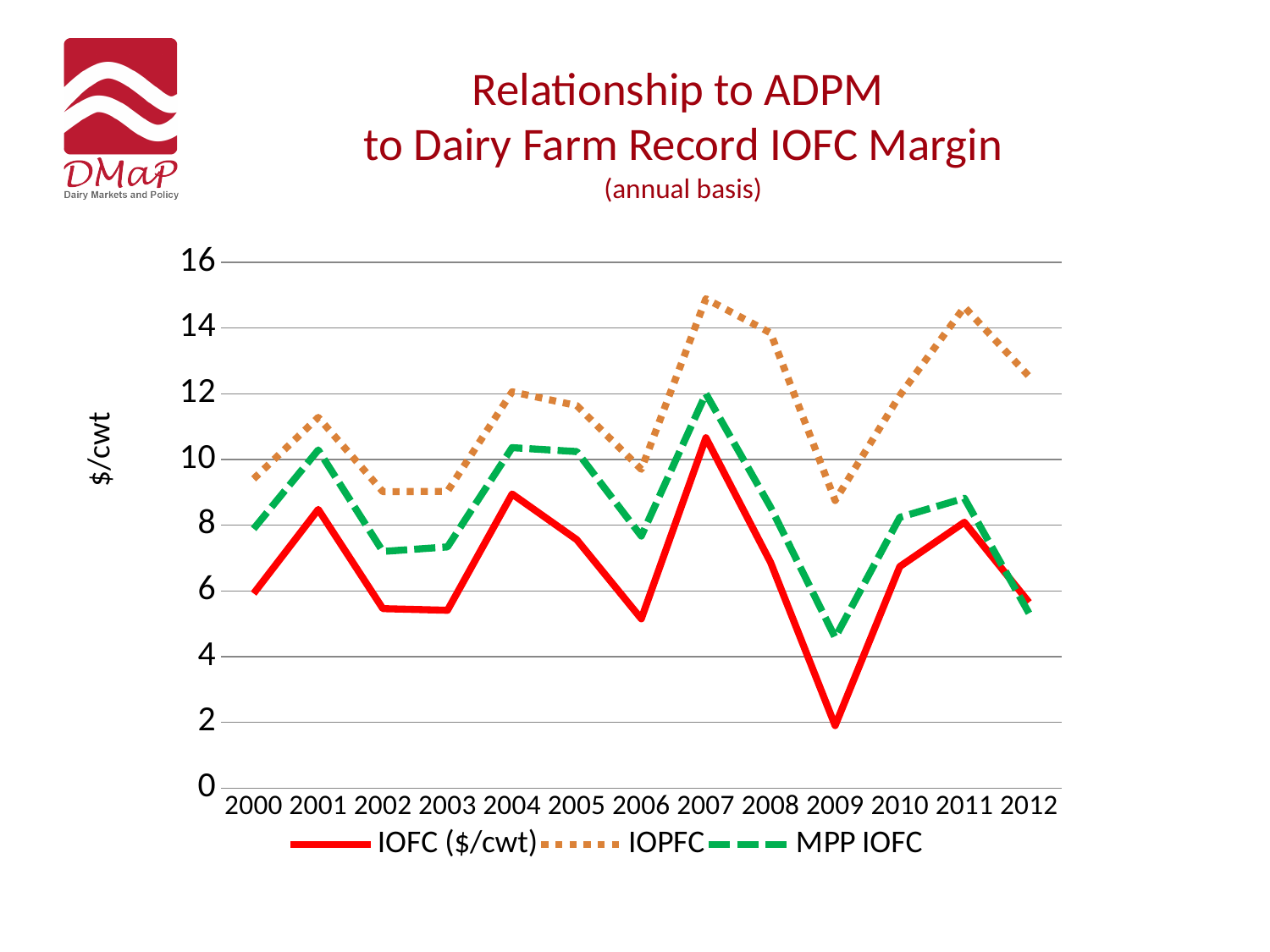
In 2001, which is larger: MPP IOFC or IOFC ($/cwt)? MPP IOFC How many years are plotted along the x axis? 13 How many series does the legend list? 3 In which year is the MPP IOFC series at its highest? 2007 Is the IOFC ($/cwt) value for 2009 greater or less than 4? less What is the label on the y axis? $/cwt Does the IOFC ($/cwt) series rise or fall from 2007 to 2009? fall What kind of chart is shown on the slide? line chart In which year is the IOFC ($/cwt) series at its highest? 2007 In which year is the IOFC ($/cwt) series at its lowest? 2009 Is the MPP IOFC value for 2009 greater or less than 6? less Is the IOPFC value for 2007 greater or less than 14? greater